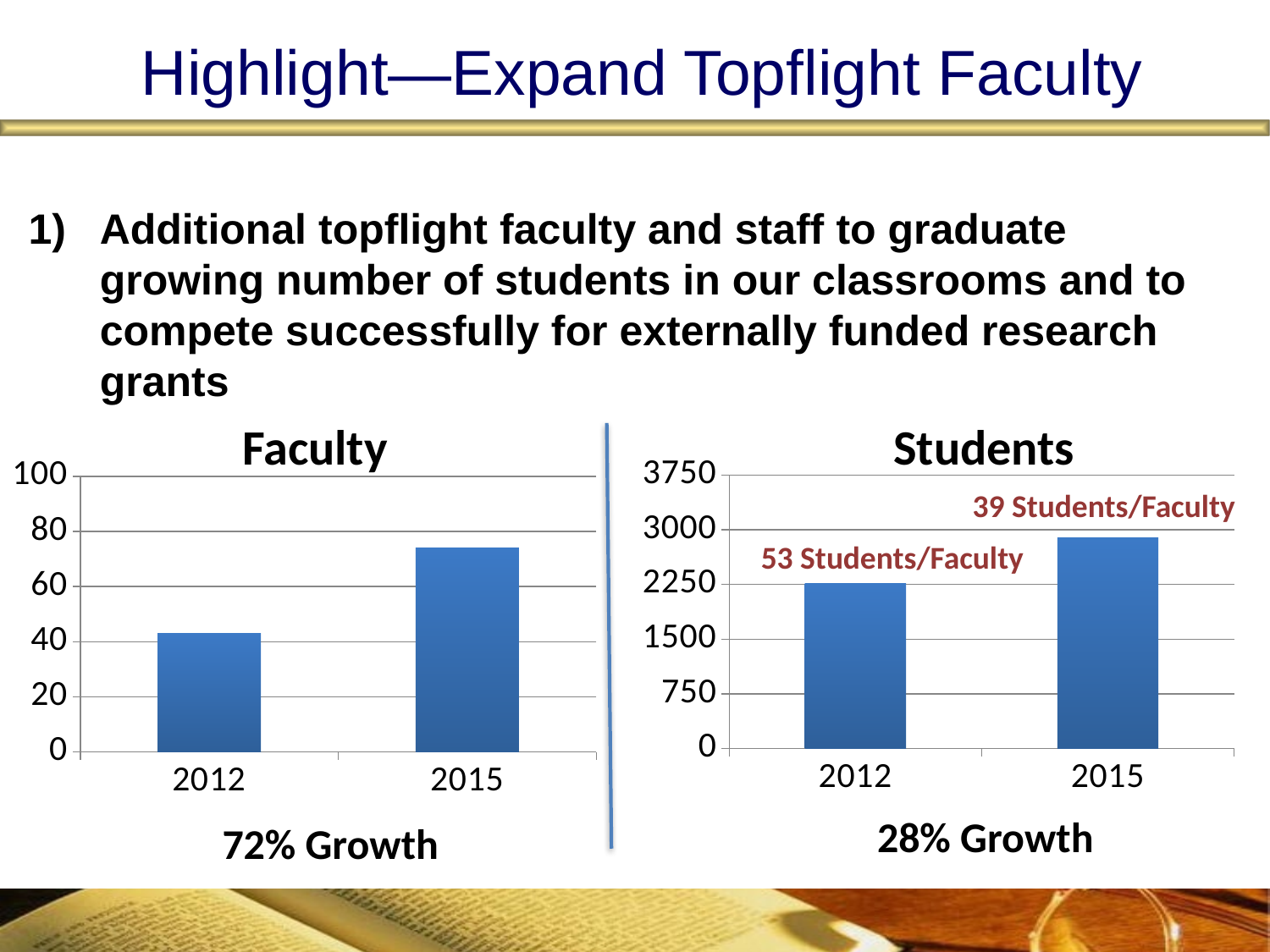
In the Students chart, is the 2015 bar taller or shorter than the 2012 bar? taller How many categories are shown on the x axis of the Students chart? 2 In the Faculty chart, is the value for 2015 greater or less than 60? greater In the Faculty chart, do the values rise or fall from 2012 to 2015? rise What students-per-faculty ratio is labelled for 2012 in the Students chart? 53 Students/Faculty What growth percentage is shown beneath the Faculty chart? 72% Growth In the Students chart, which year has the lower value? 2012 In the Students chart, is the value for 2015 greater or less than 2250? greater What kind of chart is the Faculty chart? bar chart In the Faculty chart, is the value for 2012 greater or less than 60? less In the Faculty chart, which year has the higher value? 2015